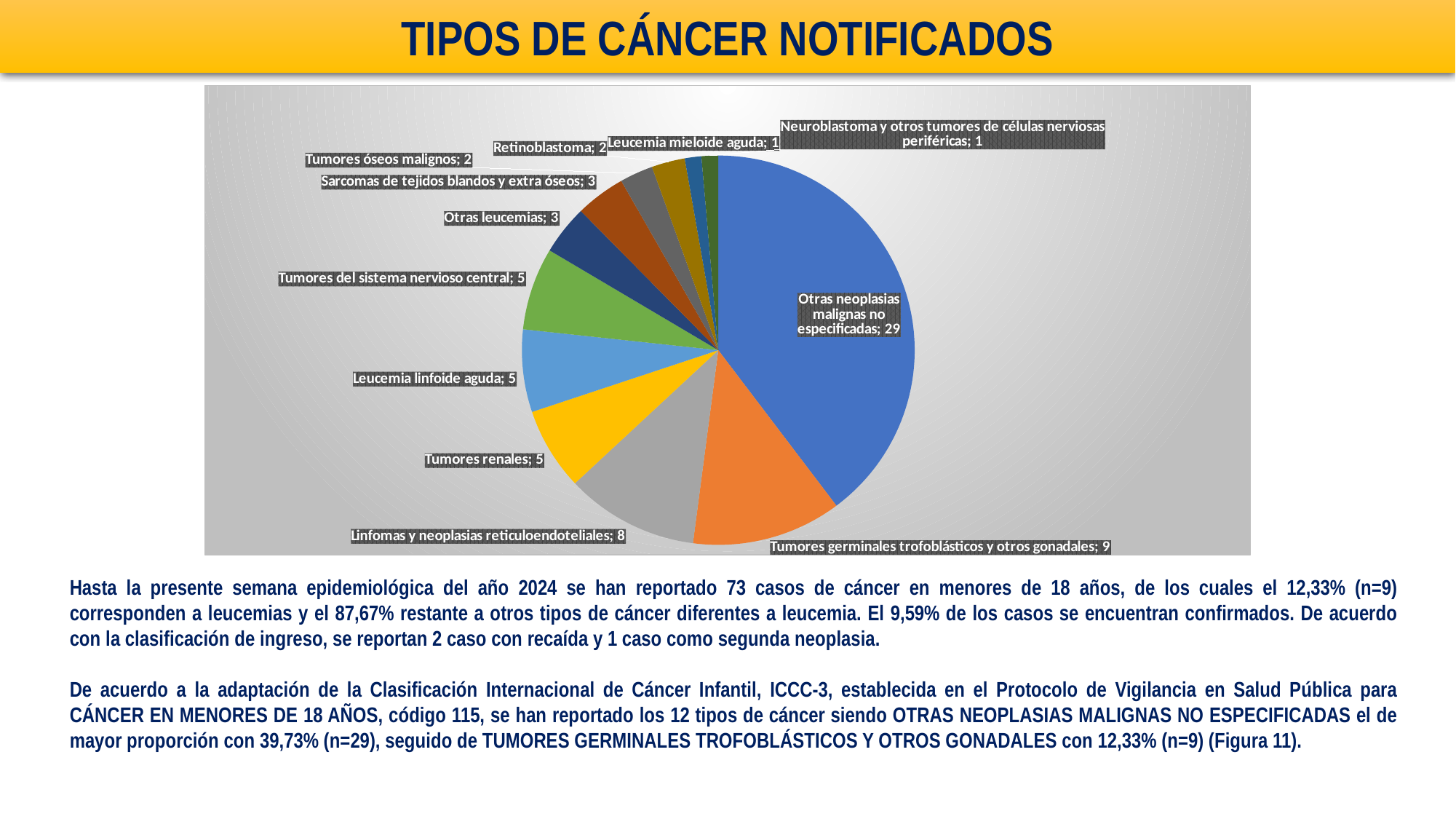
How many cancer types (slices) does the pie chart show? 12 What is the value for Tumores germinales trofoblásticos y otros gonadales? 9 What is the total of all the values shown in the pie chart? 73 What is the difference between the values for Otras neoplasias malignas no especificadas and Tumores germinales trofoblásticos y otros gonadales? 20 What colour is the slice for Tumores germinales trofoblásticos y otros gonadales? Orange What is the value for Otras neoplasias malignas no especificadas? 29 Which cancer type has the largest slice in the pie chart? Otras neoplasias malignas no especificadas What is the value for Linfomas y neoplasias reticuloendoteliales? 8 What kind of chart is shown on the slide? Pie chart What is the value for Sarcomas de tejidos blandos y extra óseos? 3 Which is larger, the value for Linfomas y neoplasias reticuloendoteliales or the value for Tumores renales? Linfomas y neoplasias reticuloendoteliales What is the value for Leucemia mieloide aguda? 1